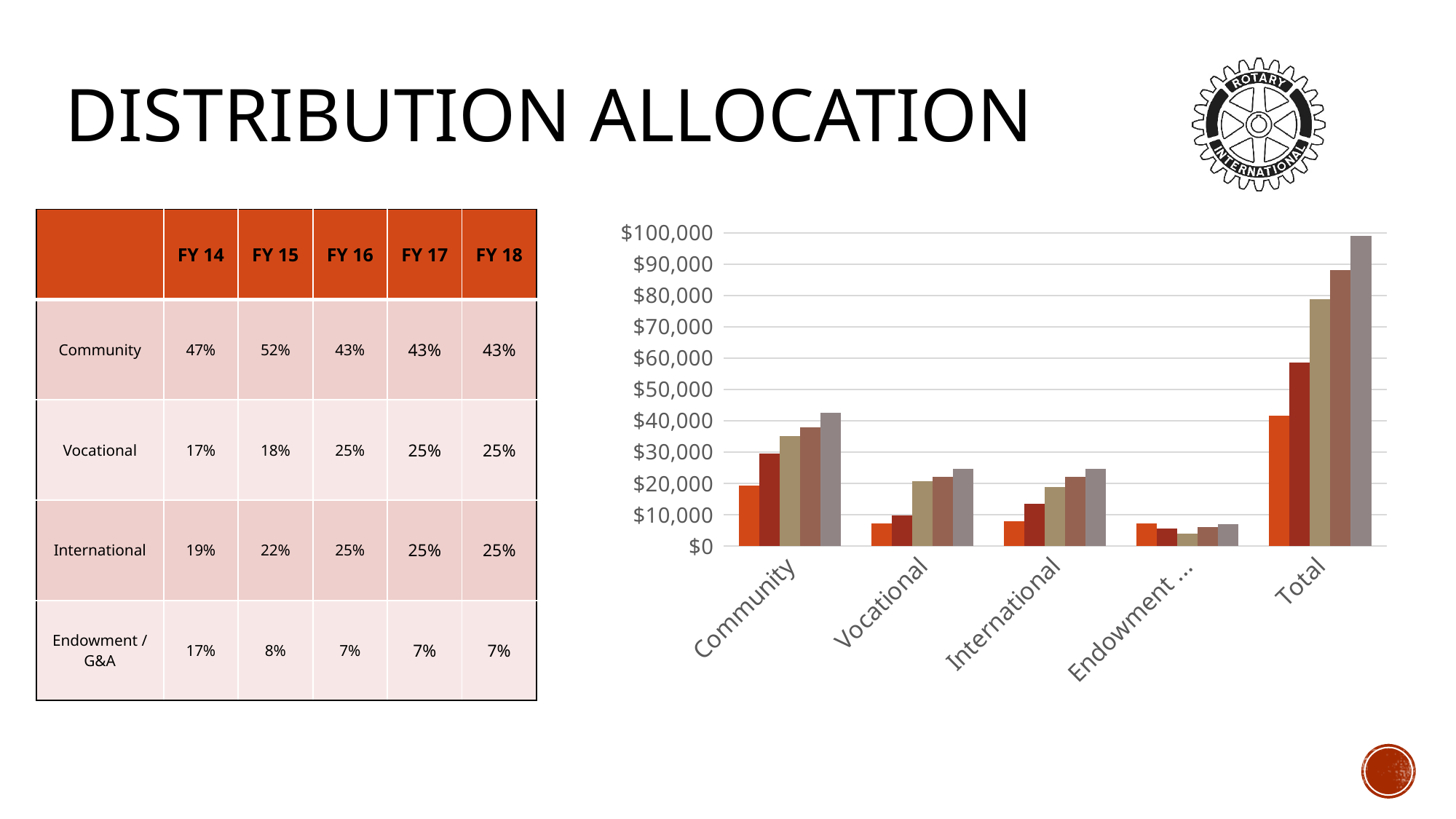
Is the value of the rightmost (grey) bar for Vocational greater or less than $20,000? greater What kind of chart is shown on the slide? bar chart Are all the bars for the Endowment category greater or less than $10,000? less How many categories are shown on the x axis of the chart? 5 How many bars are plotted for each category in the chart? 5 Is the value of the rightmost (grey) bar for Community greater or less than $40,000? greater Which category has larger bars, Community or Vocational? Community Which category has the shortest bars in the chart? Endowment Within the Total category, do the bars rise or fall from left to right? rise Which category has the tallest bars in the chart? Total